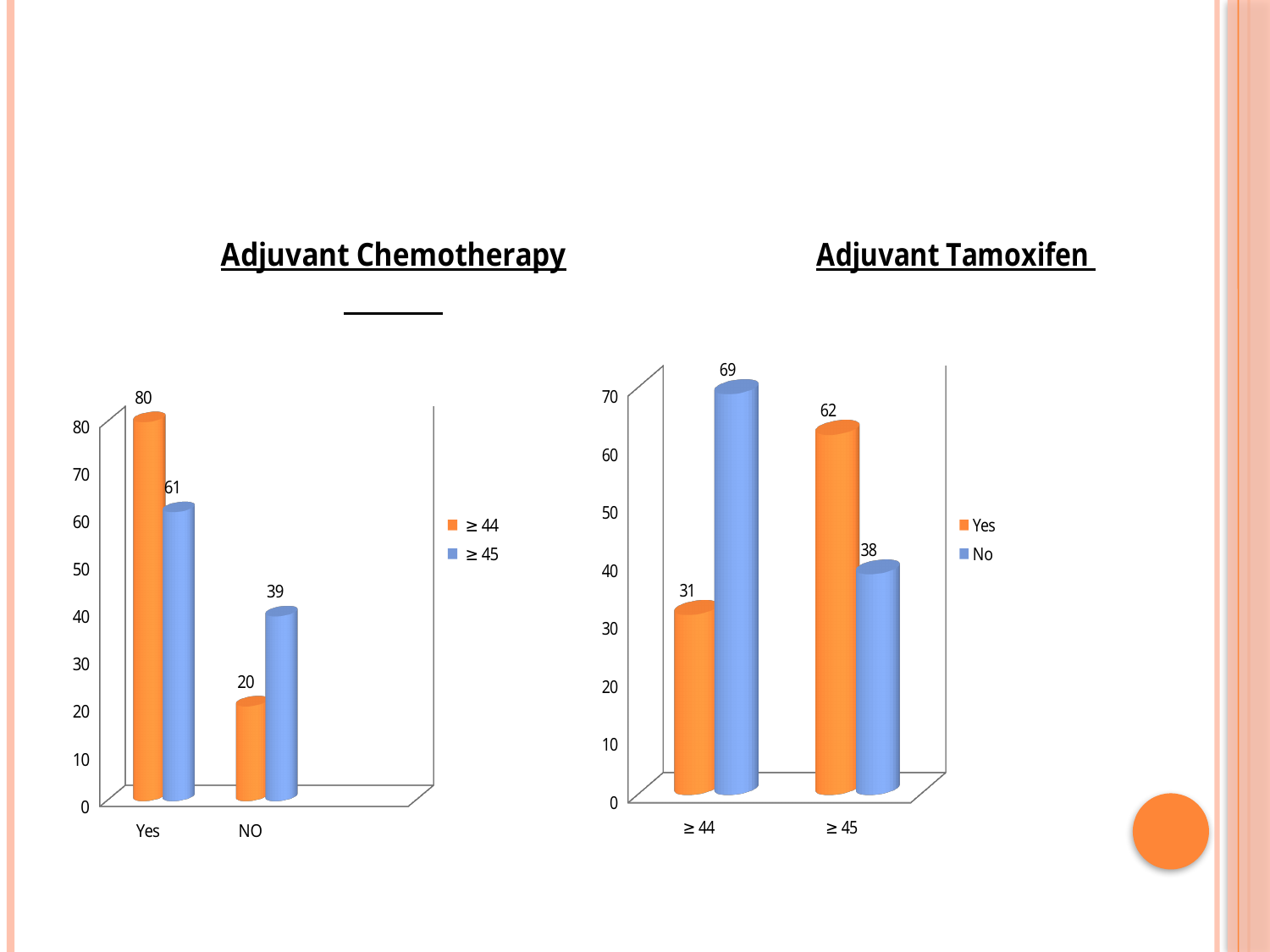
How many series does the legend of the Adjuvant Chemotherapy chart list? 2 In the Adjuvant Tamoxifen chart, what is the value for No in the ≥ 44 category? 69 In the Adjuvant Tamoxifen chart, which colour represents the Yes series? Orange What kind of chart is the Adjuvant Chemotherapy chart? Bar chart In the Adjuvant Chemotherapy chart, what is the value for Yes in the ≥ 44 series? 80 In the Adjuvant Chemotherapy chart, which category has the lowest value in the ≥ 44 series? NO In the Adjuvant Tamoxifen chart, what is the difference between the Yes and No values for ≥ 45? 24 In the Adjuvant Tamoxifen chart, which is larger for the ≥ 44 category, Yes or No? No In the Adjuvant Tamoxifen chart, what is the value for Yes in the ≥ 45 category? 62 In the Adjuvant Chemotherapy chart, what is the difference between the ≥ 44 and ≥ 45 values for Yes? 19 In the Adjuvant Chemotherapy chart, what is the value for NO in the ≥ 45 series? 39 How many categories are shown on the x axis of the Adjuvant Tamoxifen chart? 2